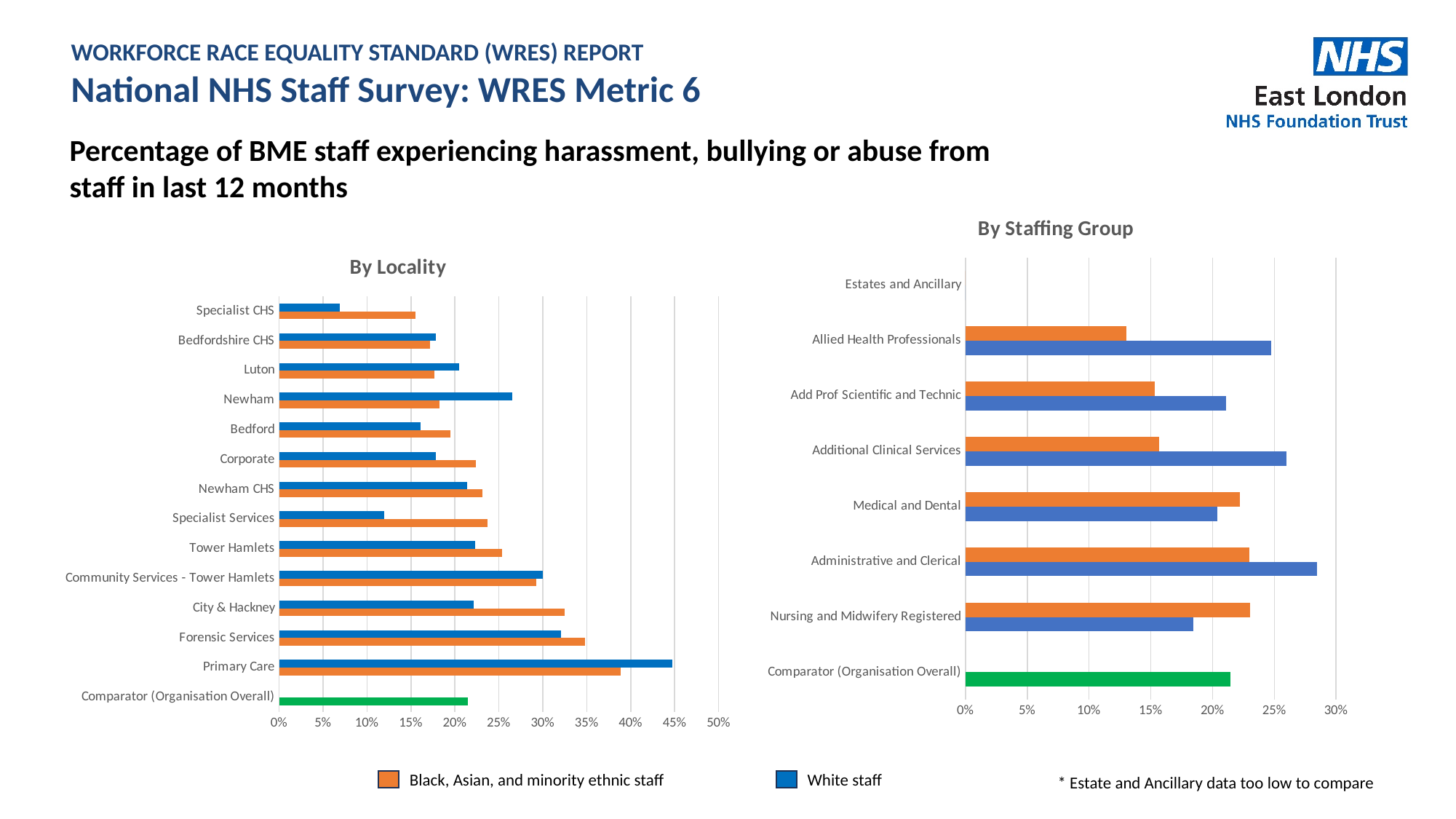
How many categories are shown on the "By Staffing Group" chart? 8 How many categories are shown on the "By Locality" chart? 14 How many series does the shared legend at the bottom of the slide list? 2 On the "By Locality" chart, is the value for Black, Asian, and minority ethnic staff in City & Hackney greater or less than 30%? greater On the "By Locality" chart, which locality has the lowest value for White staff? Specialist CHS On the "By Staffing Group" chart, is the value for Black, Asian, and minority ethnic staff in Allied Health Professionals greater or less than 15%? less What kind of chart is the "By Locality" chart? bar chart On the "By Staffing Group" chart, which staffing group has no bars plotted? Estates and Ancillary On the "By Locality" chart, is the value for White staff in Primary Care greater or less than 40%? greater On the "By Staffing Group" chart, which staffing group has the highest value for White staff? Administrative and Clerical On the "By Locality" chart, for Specialist Services, which is larger: the value for Black, Asian, and minority ethnic staff or the value for White staff? Black, Asian, and minority ethnic staff On the "By Locality" chart, which locality has the highest value for Black, Asian, and minority ethnic staff? Primary Care